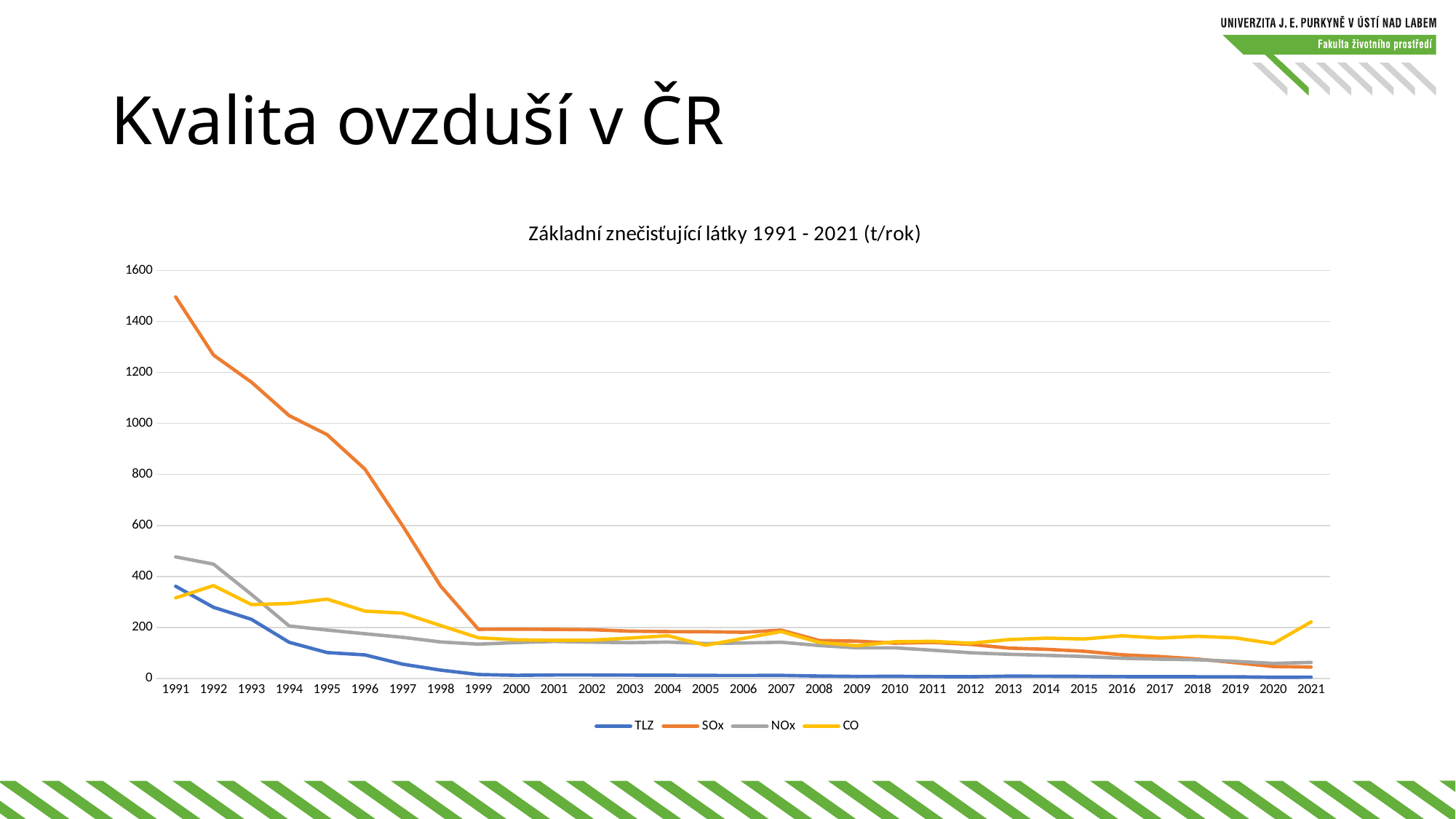
Is the value for SOx in 1991 greater or less than 1400? greater What is the title of the chart? Základní znečisťující látky 1991 - 2021 (t/rok) Is the value for SOx in 1995 greater or less than 800? greater Is the value for TLZ in 1991 greater or less than 200? greater Does the SOx series rise or fall from 1991 to 2021? fall Which series has the highest value in 1991? SOx Which series has the lowest value in 2021? TLZ How many years are plotted along the x axis? 31 Which series are listed in the legend? TLZ, SOx, NOx, CO What kind of chart is shown on the slide? line chart In 2021, which is larger, the value for CO or the value for NOx? CO How many series does the legend list? 4